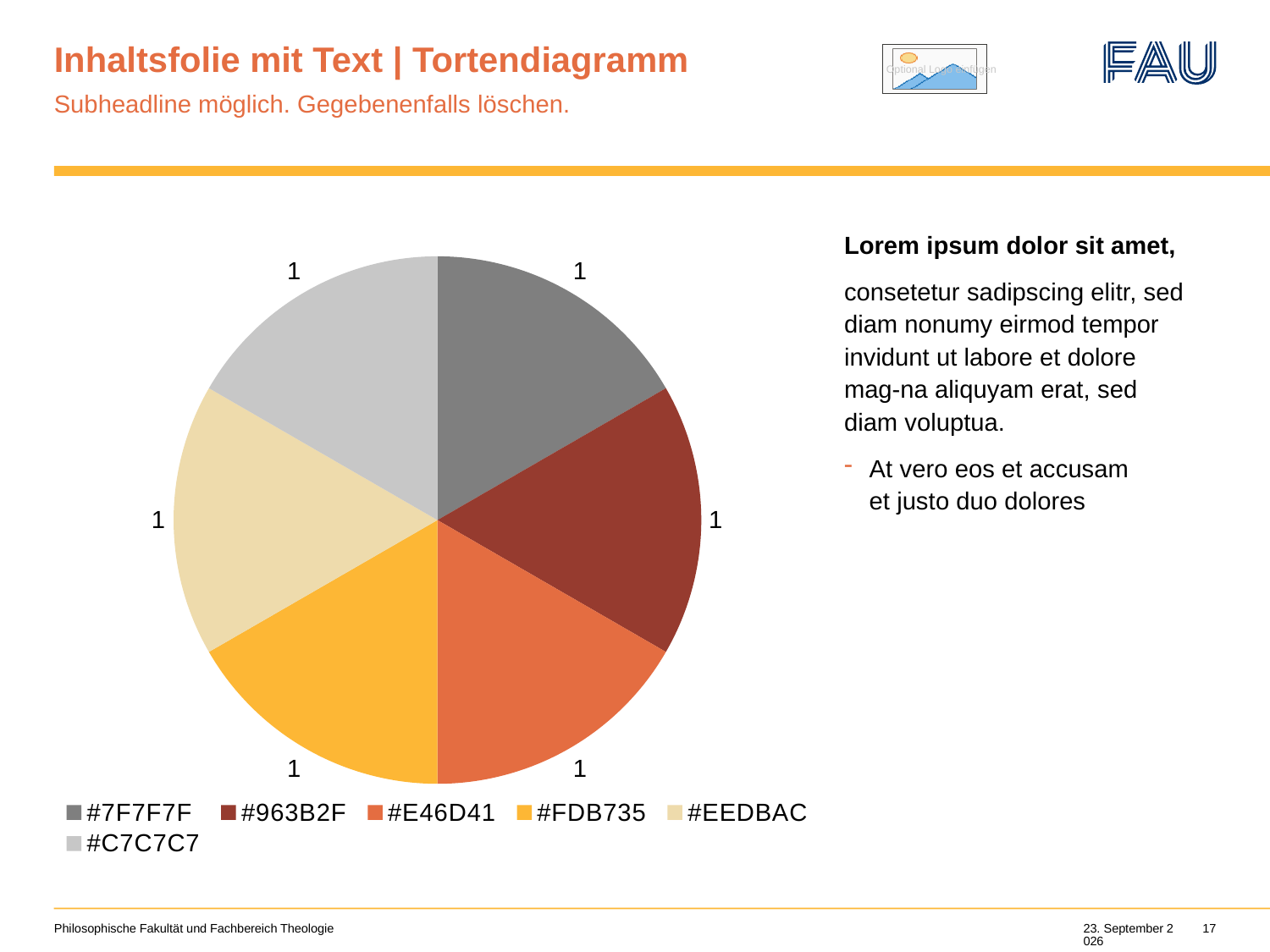
Which legend entry corresponds to the dark grey slice at the top right of the pie? #7F7F7F What is the value of the #EEDBAC slice? 1 What is the value of the #7F7F7F slice? 1 How many slices does the pie chart have? 6 What kind of chart is shown on the slide? pie chart Which legend entry is listed last in the pie chart's legend? #C7C7C7 What is the value of the #FDB735 slice? 1 What is the difference between the values of the #E46D41 and #C7C7C7 slices? 0 What share of the pie does the #963B2F slice represent? 1/6 What is the total of all slice values in the pie chart? 6 How many entries does the legend of the pie chart list? 6